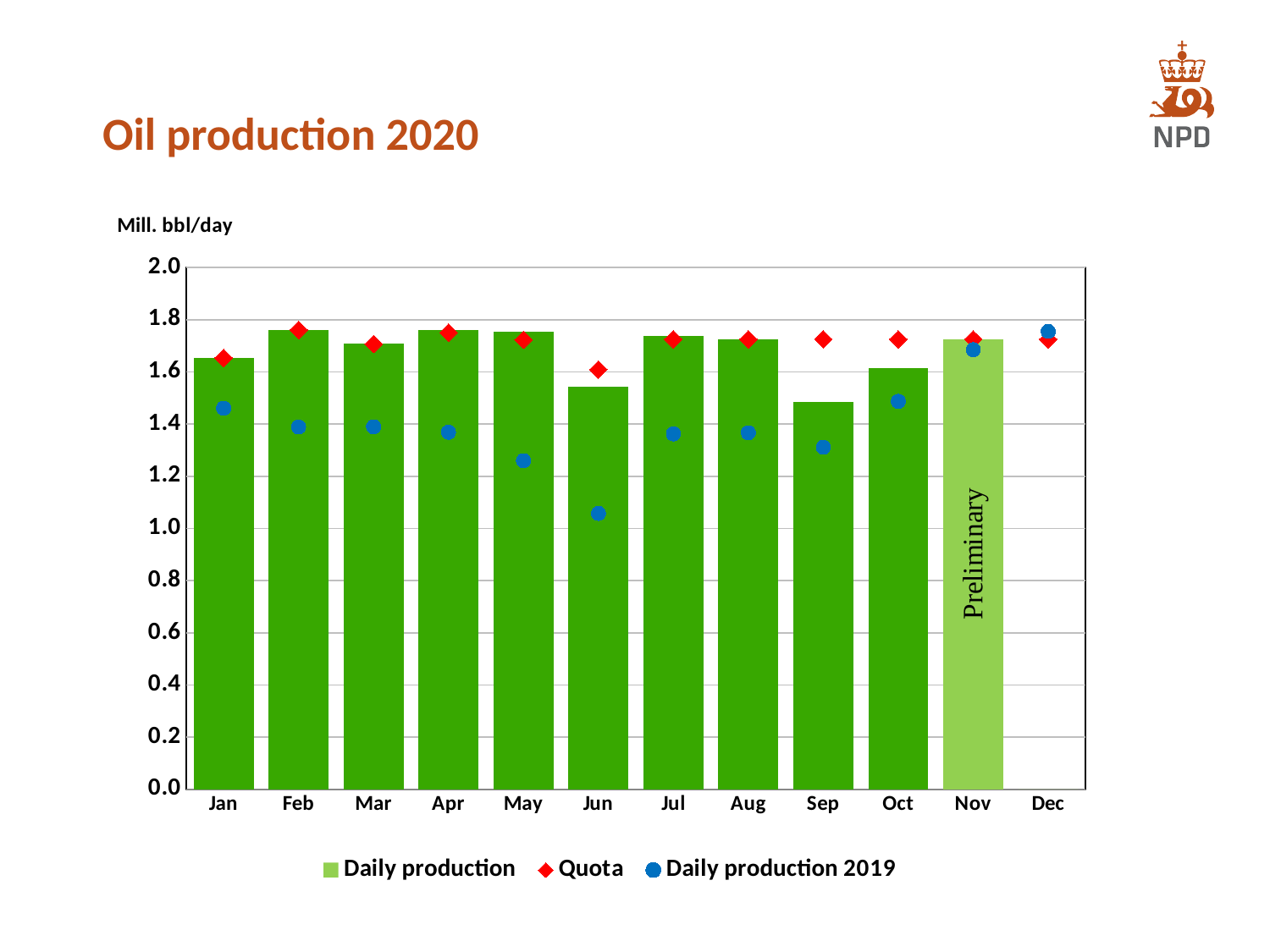
How many months are shown on the x axis? 12 Which month has the lowest Daily production bar? Sep Which month has the lowest Daily production 2019 value? Jun What unit is given for the y axis? Mill. bbl/day Do the Daily production 2019 values rise or fall from Jan to Jun? fall What kind of chart is shown on the slide? Bar chart (with point markers) Which month has the highest Daily production 2019 value? Dec Is the Daily production 2019 value for Jun greater or less than 1.2? less Is the Daily production bar for Jun greater or less than 1.6? less How many series does the legend list? 3 Which is larger, the Daily production bar for Oct or for Sep? Oct How many months have a Daily production bar? 11